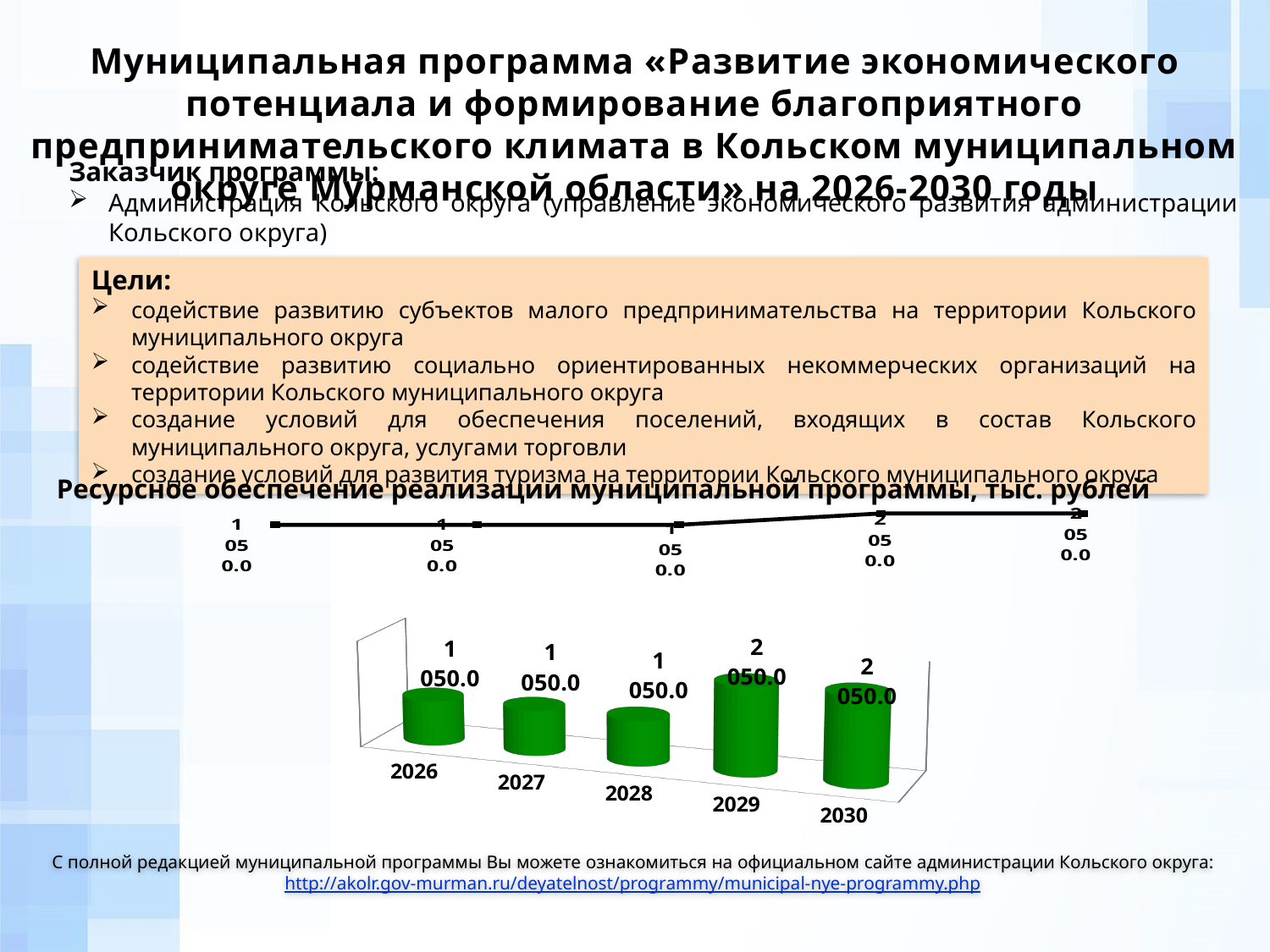
In the bar chart, what is the difference between the values for 2029 and 2026? 1 000.0 What colour are the bars in the bar chart? green In the bar chart, what is the value for 2029? 2 050.0 In the bar chart, which years share the highest value? 2029 and 2030 How many years are shown on the x axis of the bar chart? 5 In the bar chart, what is the value for 2026? 1 050.0 In the bar chart, do the values rise or fall from 2026 to 2030? rise What is the title above the chart section of the slide? Ресурсное обеспечение реализации муниципальной программы, тыс. рублей In the bar chart, what is the value for 2027? 1 050.0 In the bar chart, what is the value for 2030? 2 050.0 What kind of chart shows the values for 2026 to 2030? bar chart In the bar chart, which year has the larger value, 2028 or 2029? 2029